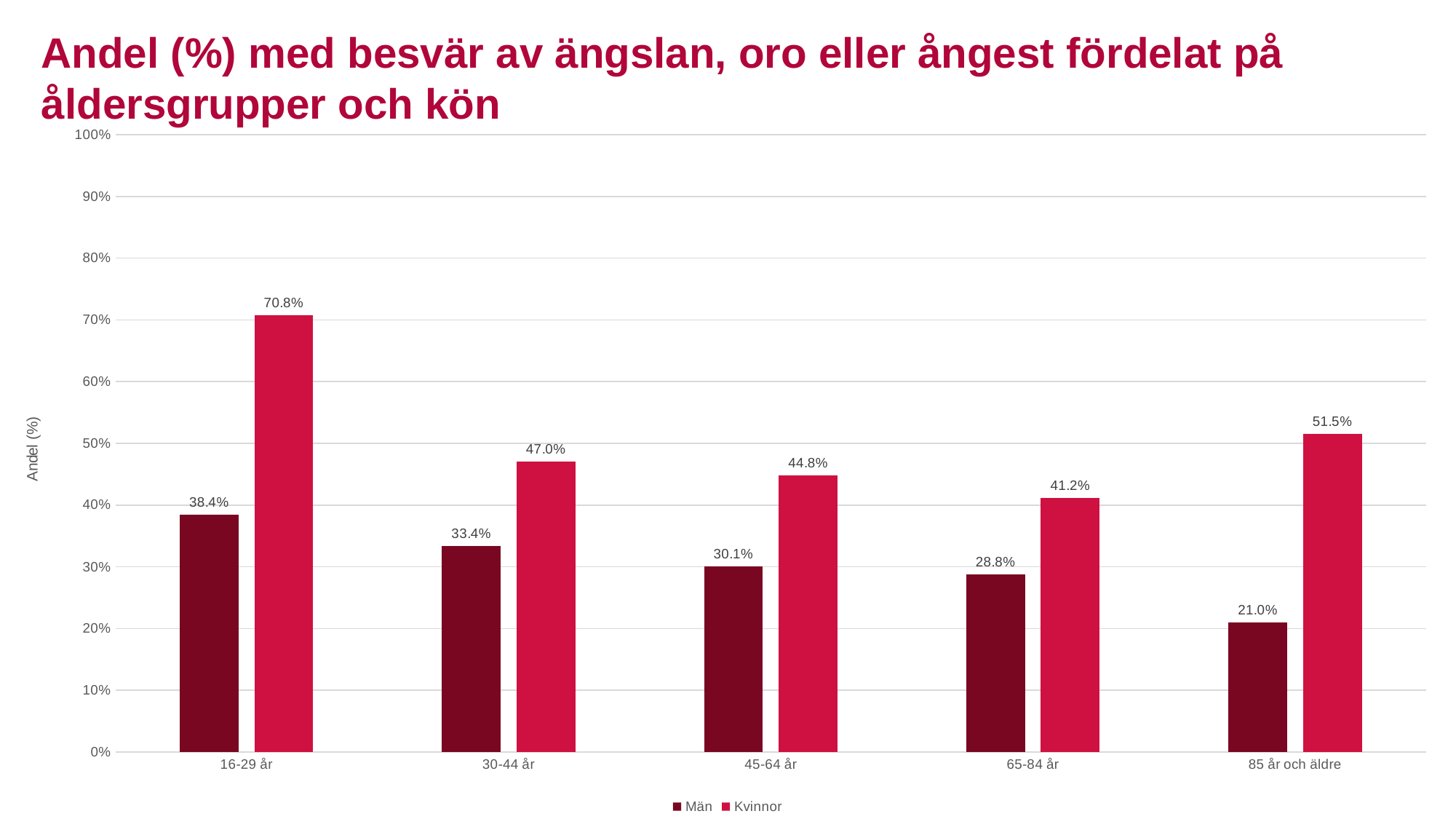
Which age group has the lowest value for Män? 85 år och äldre What is the difference between Kvinnor and Män in the 30-44 år age group? 13.6% How many age groups are shown on the x axis? 5 What is the value for Män in the 85 år och äldre age group? 21.0% What is the value for Kvinnor in the 16-29 år age group? 70.8% Do the values for Män rise or fall from 16-29 år to 85 år och äldre? Fall What is the value for Män in the 45-64 år age group? 30.1% What kind of chart is shown on the slide? Bar chart Which age group has the highest value for Kvinnor? 16-29 år Is the value for Kvinnor in the 85 år och äldre age group greater or less than 50%? greater Which is larger in the 65-84 år age group, Män or Kvinnor? Kvinnor How many series does the legend list? 2